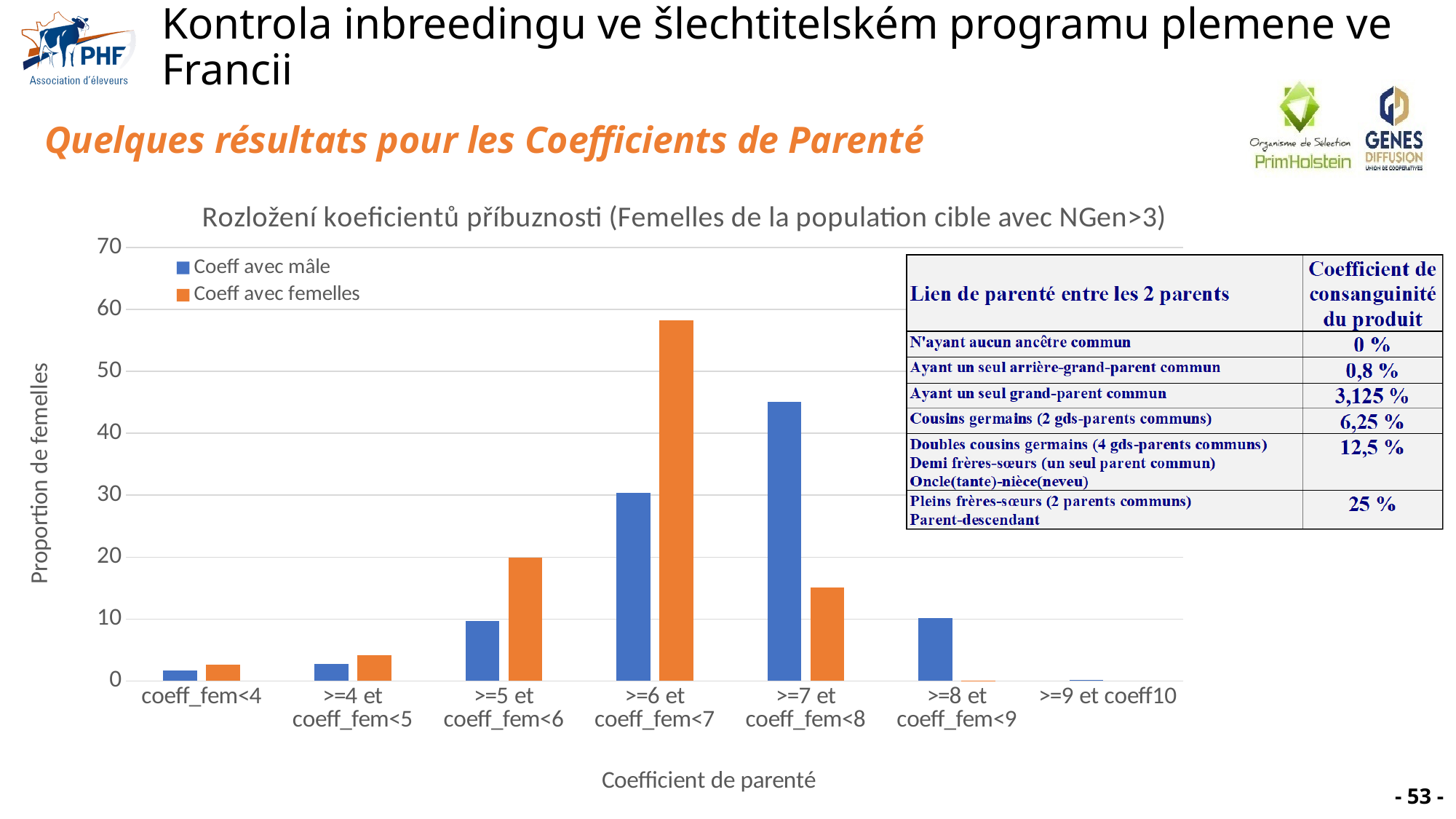
What is the title of the chart? Rozložení koeficientů příbuznosti (Femelles de la population cible avec NGen>3) Is the value for 'Coeff avec femelles' in the category '>=7 et coeff_fem<8' greater or less than 20? less Is the value for 'Coeff avec mâle' in the category '>=7 et coeff_fem<8' greater or less than 40? greater For the series 'Coeff avec femelles', which category has the highest bar? >=6 et coeff_fem<7 How many series does the chart legend list? 2 How many categories are shown along the x axis of the chart? 7 For the series 'Coeff avec mâle', which category has the highest bar? >=7 et coeff_fem<8 What is the label of the y axis of the chart? Proportion de femelles In the category '>=7 et coeff_fem<8', which series has the larger value, 'Coeff avec mâle' or 'Coeff avec femelles'? Coeff avec mâle In the category '>=6 et coeff_fem<7', which series has the larger value, 'Coeff avec mâle' or 'Coeff avec femelles'? Coeff avec femelles What kind of chart is shown on the slide? bar chart Is the value for 'Coeff avec femelles' in the category '>=6 et coeff_fem<7' greater or less than 50? greater